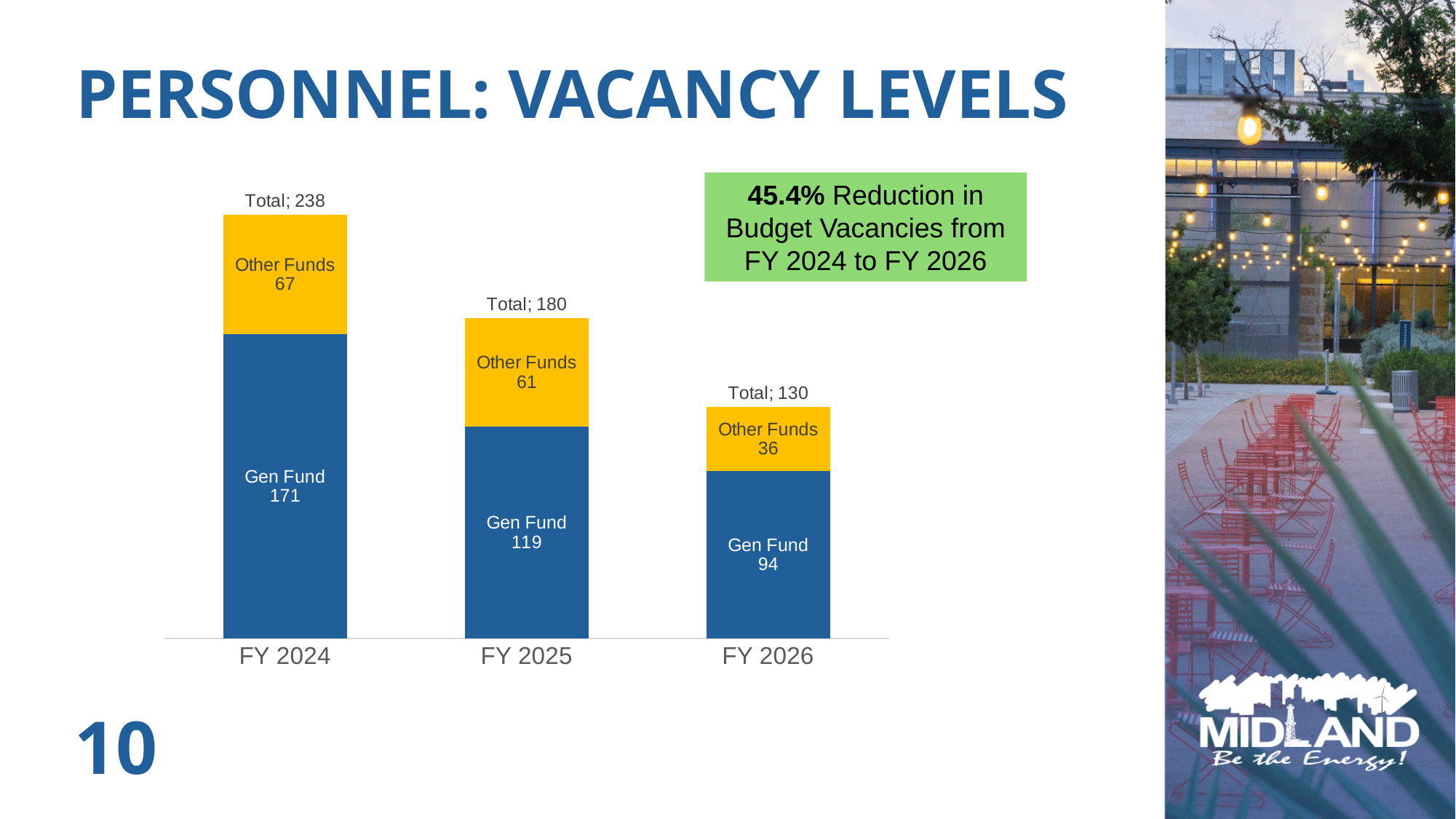
Do the total vacancies rise or fall from FY 2024 to FY 2026? Fall What is the total of the stacked bar for FY 2025? 180 What is the Gen Fund value for FY 2026? 94 How many fiscal years are shown on the x axis? 3 Which is larger, the Other Funds value for FY 2024 or for FY 2026? FY 2024 What is the total of the stacked bar for FY 2026? 130 What is the Gen Fund value for FY 2024? 171 What is the Other Funds value for FY 2025? 61 Which fiscal year has the highest total vacancies? FY 2024 Which fiscal year has the lowest Other Funds value? FY 2026 What kind of chart is shown on the slide? Stacked bar chart What is the difference between the Gen Fund values for FY 2024 and FY 2025? 52